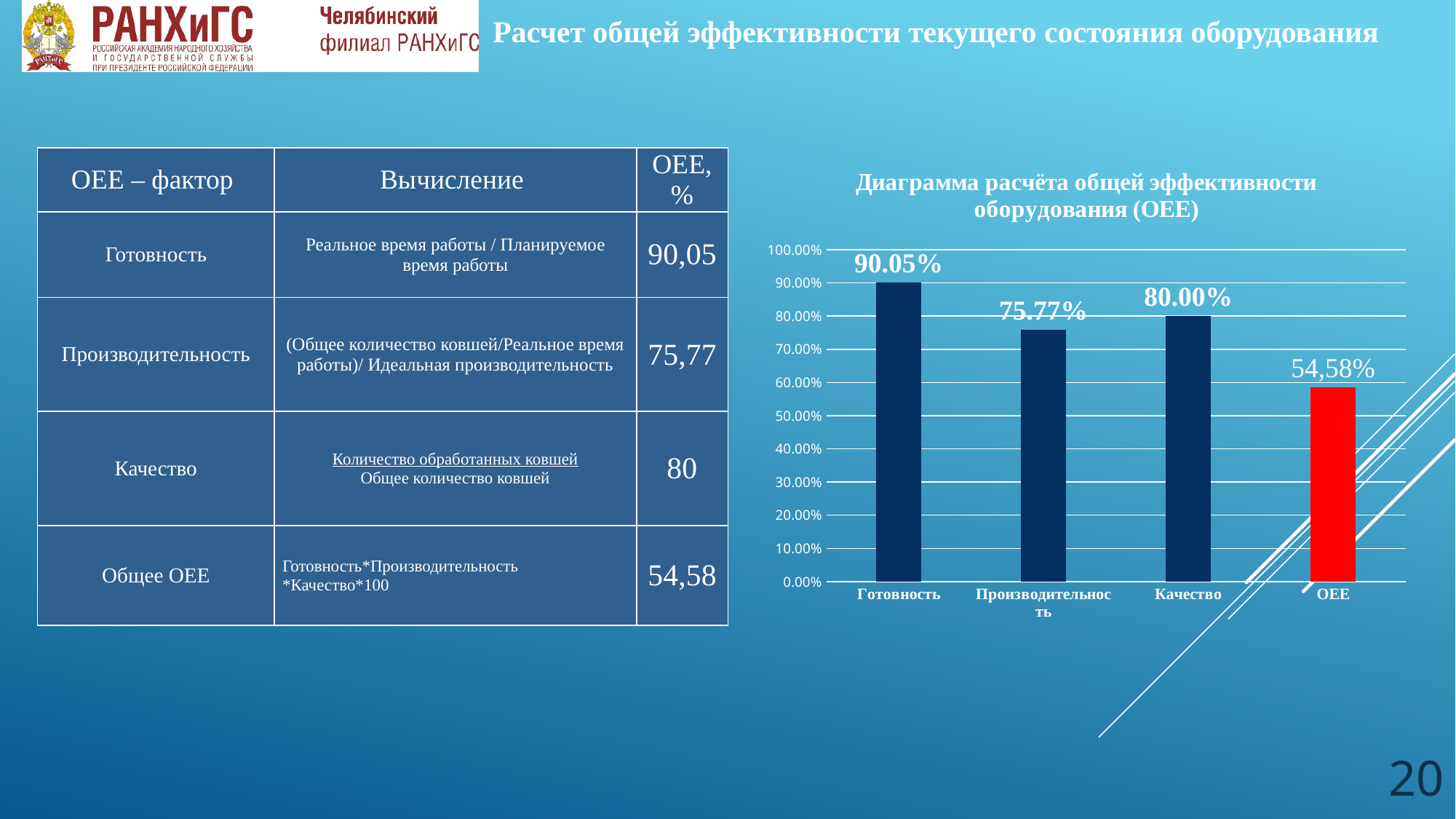
What is the value shown for OEE on the chart? 54,58% What is the value shown for Готовность on the chart? 90.05% What is the difference between the values for Качество and Производительность? 4.23 percentage points What is the value shown for Качество on the chart? 80.00% What type of chart is shown on the slide? Bar chart Which category has the highest value on the chart? Готовность What is the value shown for Производительность on the chart? 75.77% Which is larger, the value for Качество or the value for Производительность? Качество What is the difference between the values for Готовность and Производительность? 14.28 percentage points Which bar on the chart is coloured red? OEE Which category has the lowest value on the chart? OEE How many categories are shown on the chart? 4